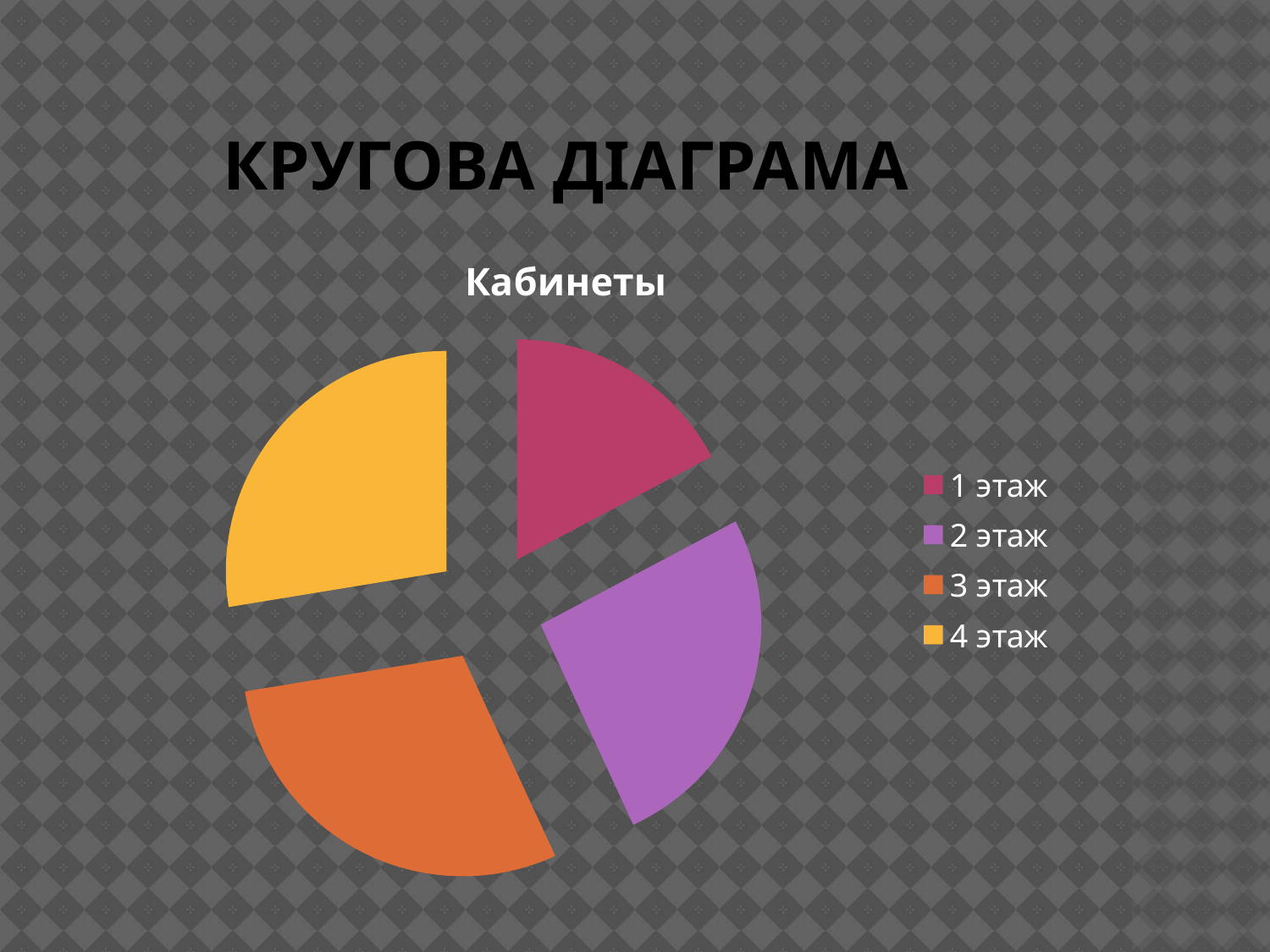
What kind of chart is shown on the slide? pie chart Which category has the smallest slice of the pie? 1 этаж Which slice is larger, 1 этаж or 3 этаж? 3 этаж Which slice is larger, 1 этаж or 2 этаж? 2 этаж What colour is the slice for 4 этаж? yellow How many entries does the legend list? 4 How many slices does the pie chart have? 4 What is the title of the chart? Кабинеты Which slice is larger, 1 этаж or 4 этаж? 4 этаж